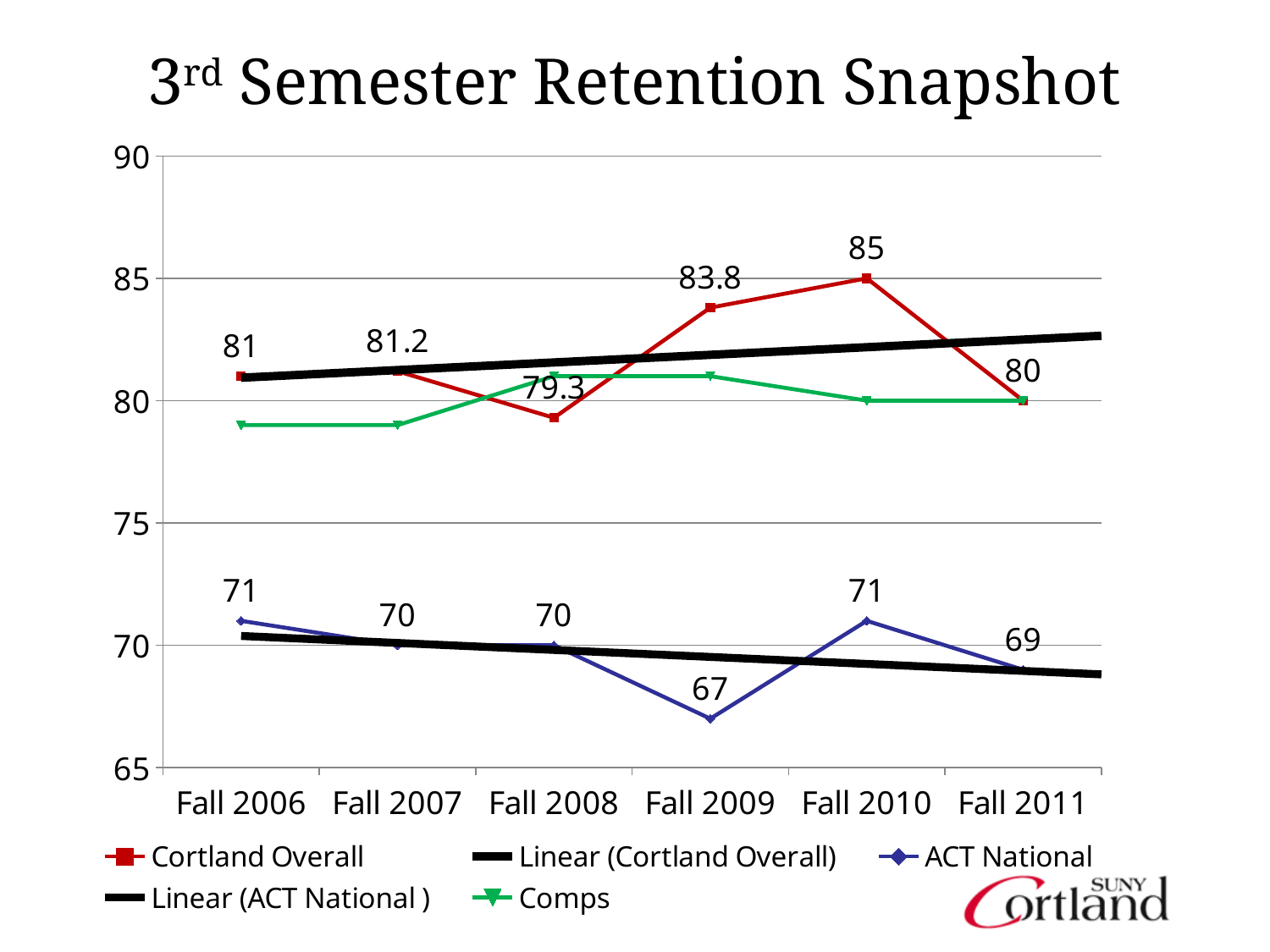
What is the Cortland Overall value for Fall 2008? 79.3 What is the title of the chart? 3rd Semester Retention Snapshot How many entries does the legend list? 5 What is the Cortland Overall value for Fall 2010? 85 What kind of chart is shown on the slide? line chart Which is larger, the Cortland Overall value for Fall 2009 or for Fall 2007? Fall 2009 Is the Comps value for Fall 2006 greater or less than 80? less What is the difference between the Cortland Overall values for Fall 2010 and Fall 2011? 5 In which semester is the ACT National value lowest? Fall 2009 In which semester is the Cortland Overall value highest? Fall 2010 How many semesters are shown on the x axis? 6 What is the ACT National value for Fall 2009? 67